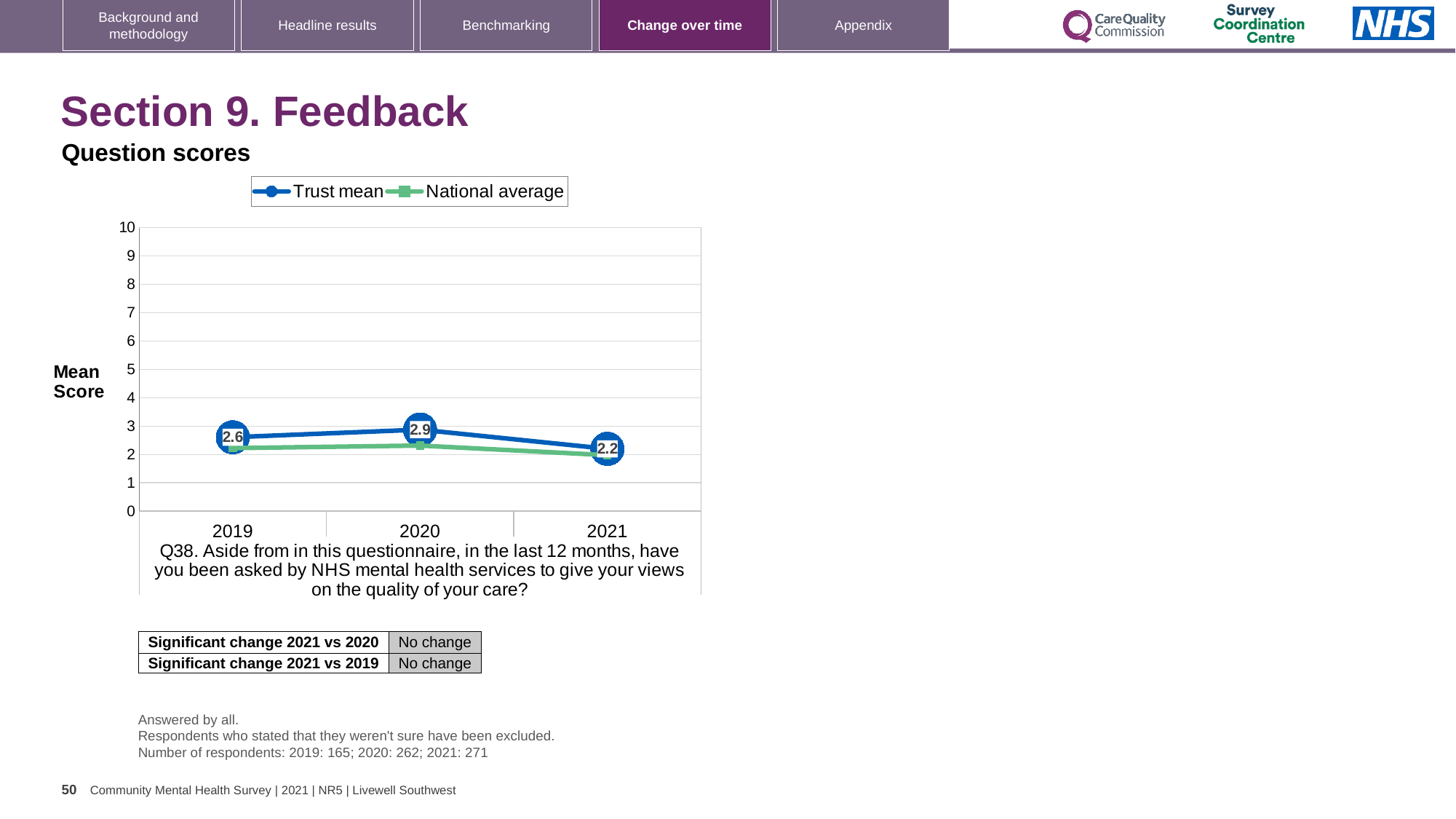
Does the Trust mean score rise or fall from 2020 to 2021? fall What is the Trust mean score for 2021? 2.2 How many series does the legend list? 2 What is the difference between the Trust mean scores for 2020 and 2021? 0.7 What kind of chart is shown on the slide? line chart How many years are plotted on the x axis? 3 What is the Trust mean score for 2020? 2.9 In which year is the Trust mean score highest? 2020 What is the Trust mean score for 2019? 2.6 Is the National average value for 2020 greater or less than 3? less In which year is the Trust mean score lowest? 2021 Which year has the larger Trust mean score, 2019 or 2021? 2019